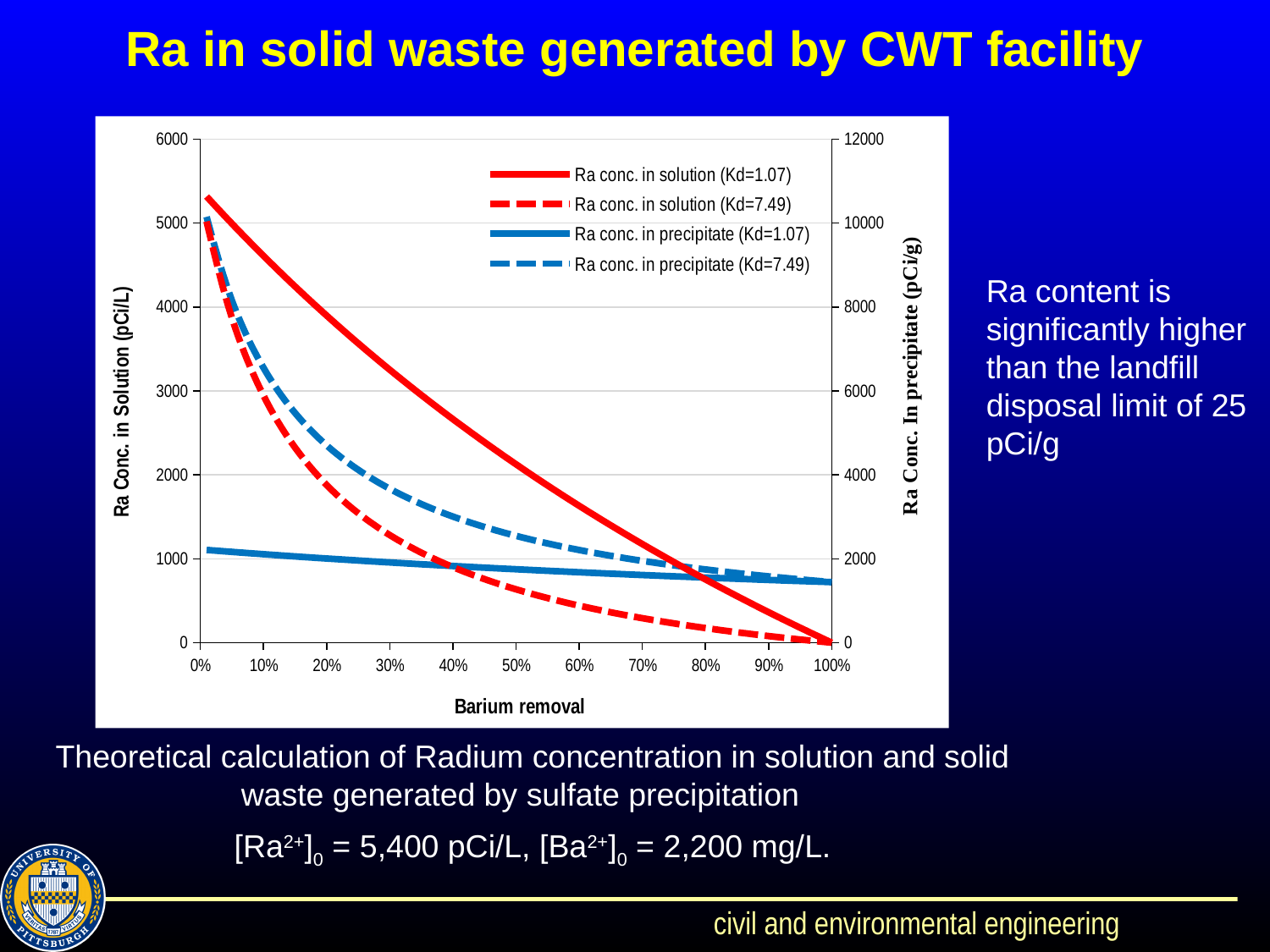
Does the Ra conc. in precipitate (Kd=7.49) line rise or fall as barium removal increases? fall What is the label of the x axis of the chart? Barium removal At 20% barium removal, which is larger: Ra conc. in solution (Kd=1.07) or Ra conc. in solution (Kd=7.49)? Ra conc. in solution (Kd=1.07) At 10% barium removal, which is larger: Ra conc. in precipitate (Kd=7.49) or Ra conc. in precipitate (Kd=1.07)? Ra conc. in precipitate (Kd=7.49) Is the value of Ra conc. in solution (Kd=1.07) at 0% barium removal greater or less than 5000 pCi/L? greater Does the Ra conc. in solution (Kd=1.07) line rise or fall as barium removal increases? fall How many series does the chart legend list? 4 Is the value of Ra conc. in precipitate (Kd=1.07) at 0% barium removal greater or less than 4000 pCi/g? less What kind of chart is shown on the slide? line chart Is the value of Ra conc. in solution (Kd=7.49) at 50% barium removal greater or less than 1000 pCi/L? less What is the title of the right-hand y axis of the chart? Ra Conc. In precipitate (pCi/g)